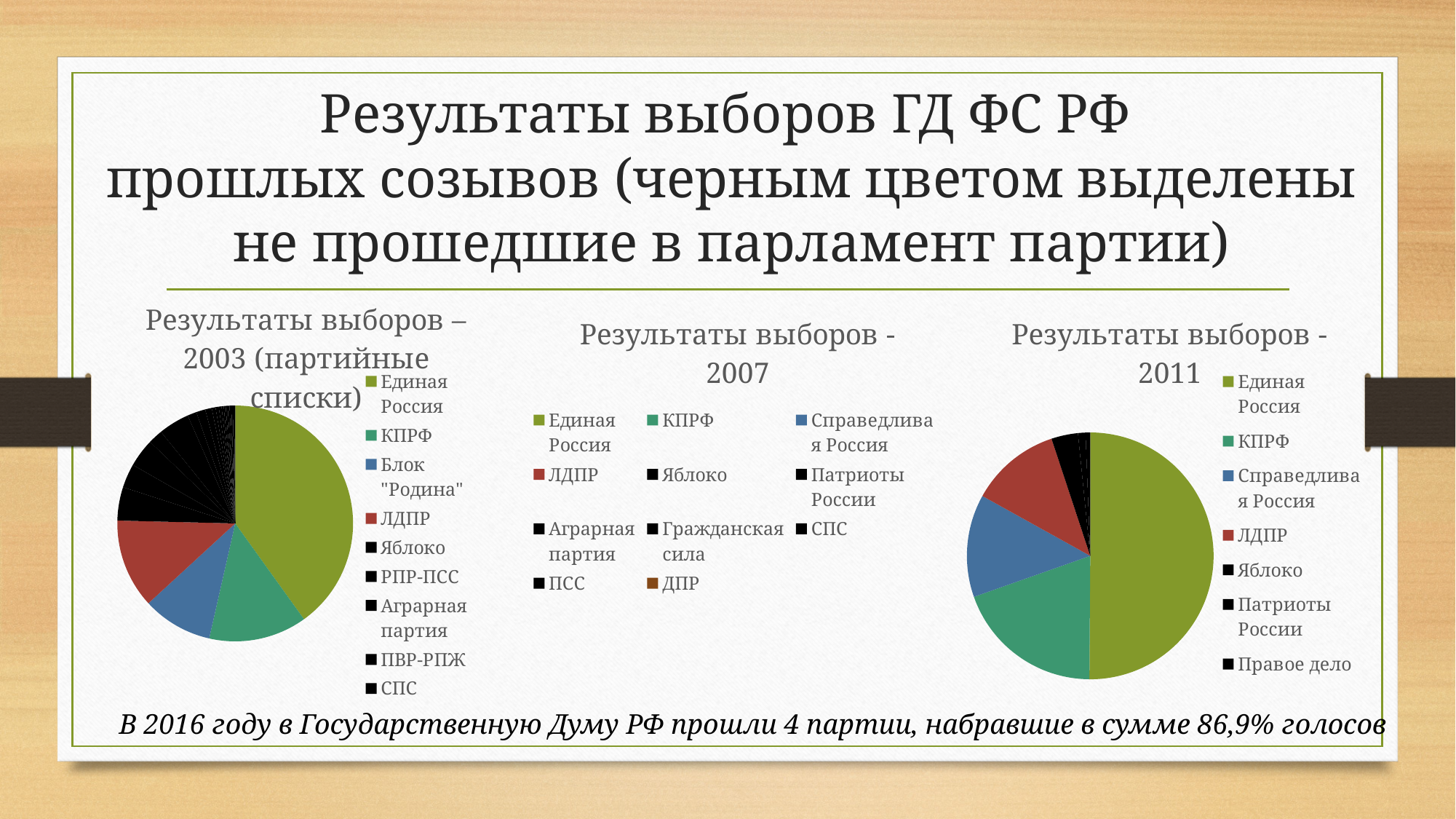
What kind of chart is the 'Результаты выборов – 2003 (партийные списки)' chart? pie chart In the 'Результаты выборов - 2011' chart, what colour is the slice for Единая Россия? green In the 'Результаты выборов - 2011' chart, which slice is larger: КПРФ or ЛДПР? КПРФ In the 'Результаты выборов – 2003 (партийные списки)' chart, which party has the largest slice? Единая Россия In the 'Результаты выборов - 2011' chart, which party has the largest slice? Единая Россия In the 'Результаты выборов - 2011' chart, which slice is larger: Единая Россия or Справедливая Россия? Единая Россия In the 'Результаты выборов - 2007' legend, which party is shown in brown? ДПР How many parties are listed in the legend of the 'Результаты выборов - 2007' chart? 11 How many parties are listed in the legend of the 'Результаты выборов – 2003 (партийные списки)' chart? 9 In the 'Результаты выборов – 2003 (партийные списки)' chart, which slice is larger: Единая Россия or КПРФ? Единая Россия What kind of chart is the 'Результаты выборов - 2011' chart? pie chart How many parties are listed in the legend of the 'Результаты выборов - 2011' chart? 7